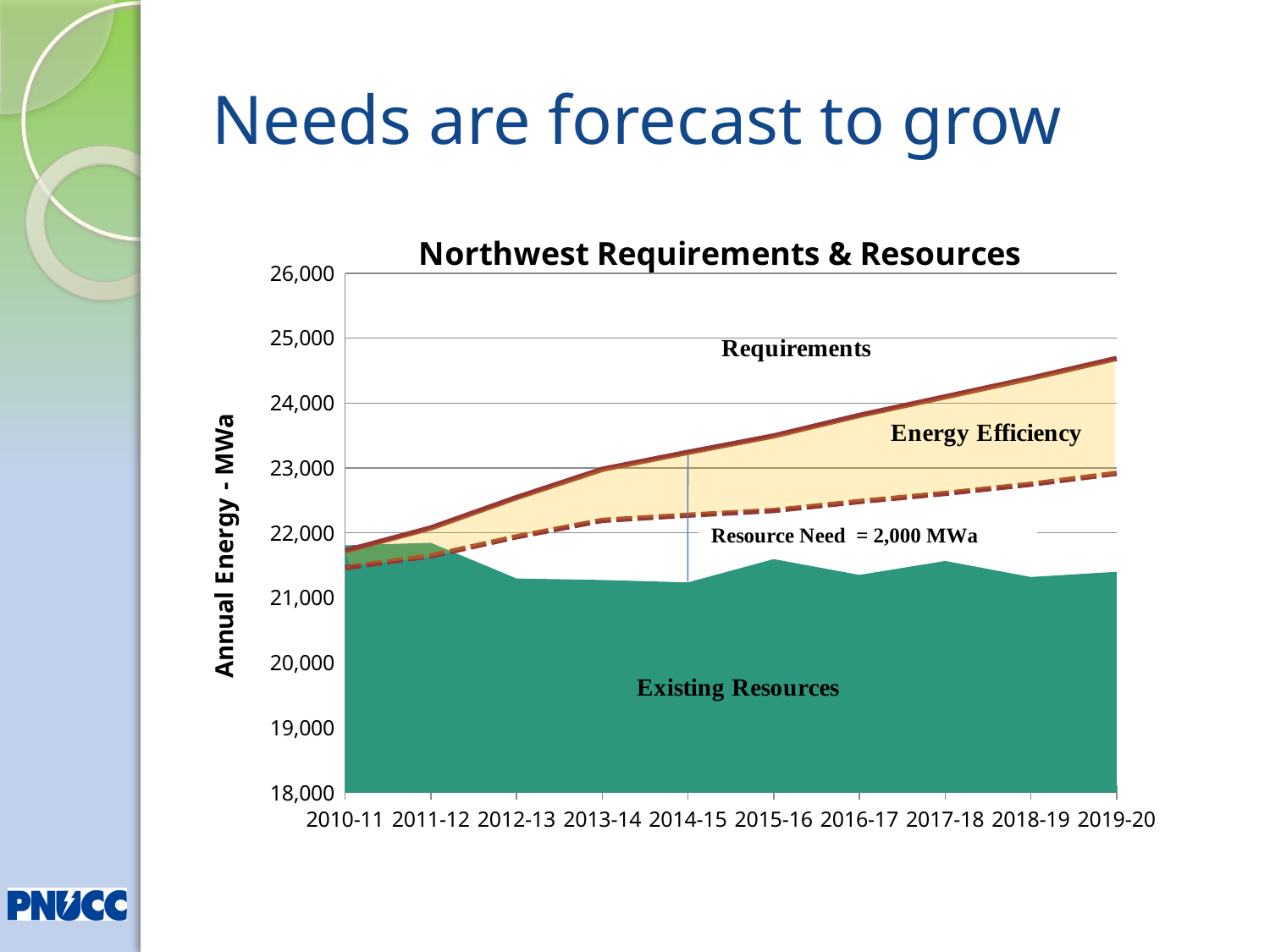
In 2019-20, which is larger: Requirements or Existing Resources? Requirements What is the title of the chart? Northwest Requirements & Resources What Resource Need is stated on the chart for 2014-15? 2,000 MWa Do the Requirements rise or fall from 2010-11 to 2019-20? rise Is the Requirements value for 2019-20 greater or less than 24,000? greater How many years are shown along the x axis of the chart? 10 What kind of chart is shown on the slide? combination area and line chart Is the Existing Resources value for 2014-15 greater or less than 22,000? less In which year are the Requirements highest? 2019-20 Is the Requirements value for 2010-11 greater or less than 22,000? less In which year are the Requirements lowest? 2010-11 What is the label on the vertical axis of the chart? Annual Energy - MWa